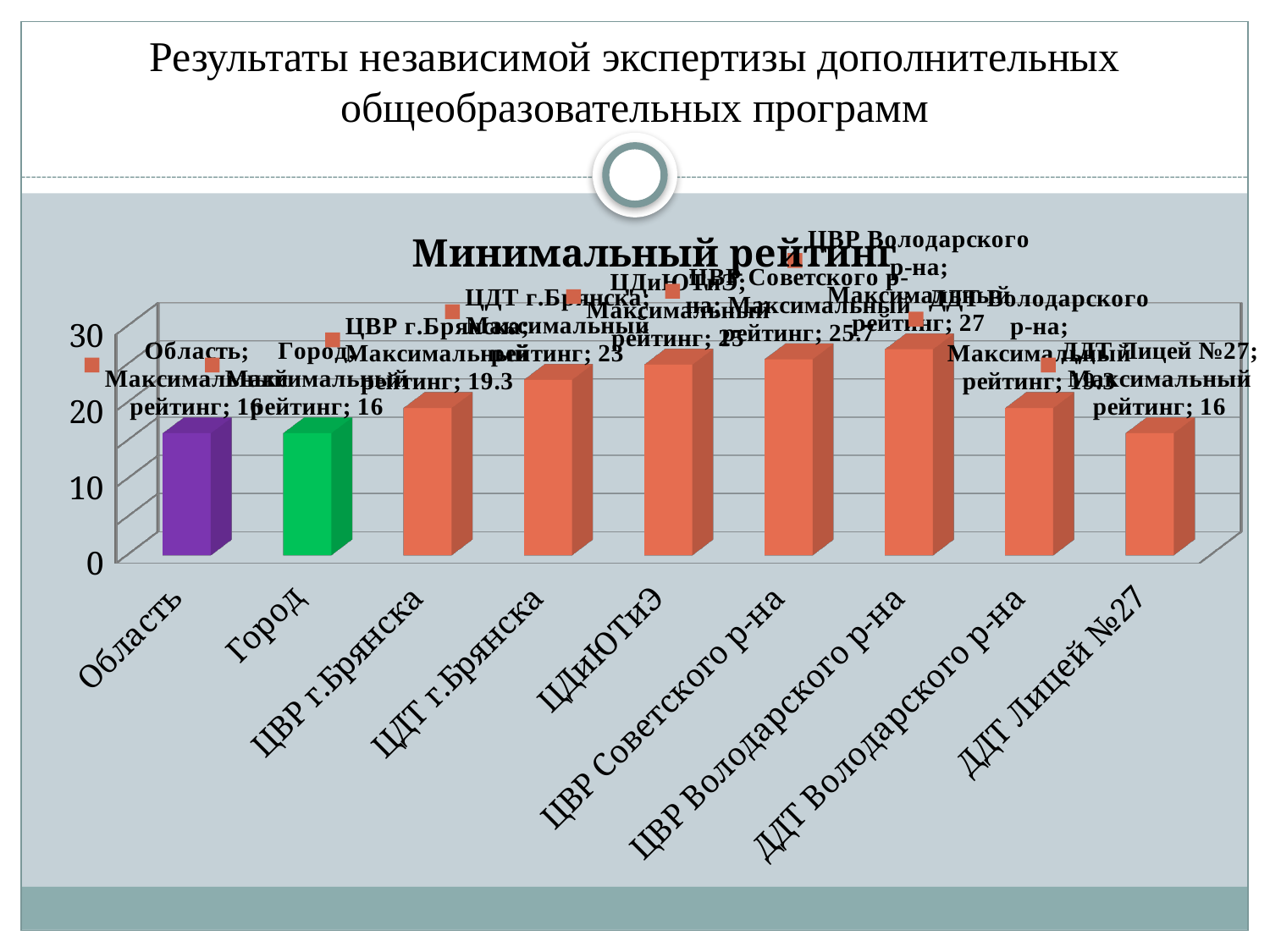
What is the value for ЦВР г.Брянска? 19.3 Which category has the highest value? ЦВР Володарского р-на What kind of chart is shown on the slide? bar chart Is the value for Город greater or less than 20? less Which is larger, the value for ЦВР Советского р-на or the value for ЦДТ г.Брянска? ЦВР Советского р-на What is the value for ДДТ Лицей №27? 16 How many categories are shown on the x axis? 9 What is the value for ЦВР Володарского р-на? 27 What is the value for ЦВР Советского р-на? 25.7 What is the difference between the values for ЦВР Советского р-на and ДДТ Володарского р-на? 6.4 What is the difference between the values for ЦВР Володарского р-на and Область? 11 What is the title of the chart? Минимальный рейтинг